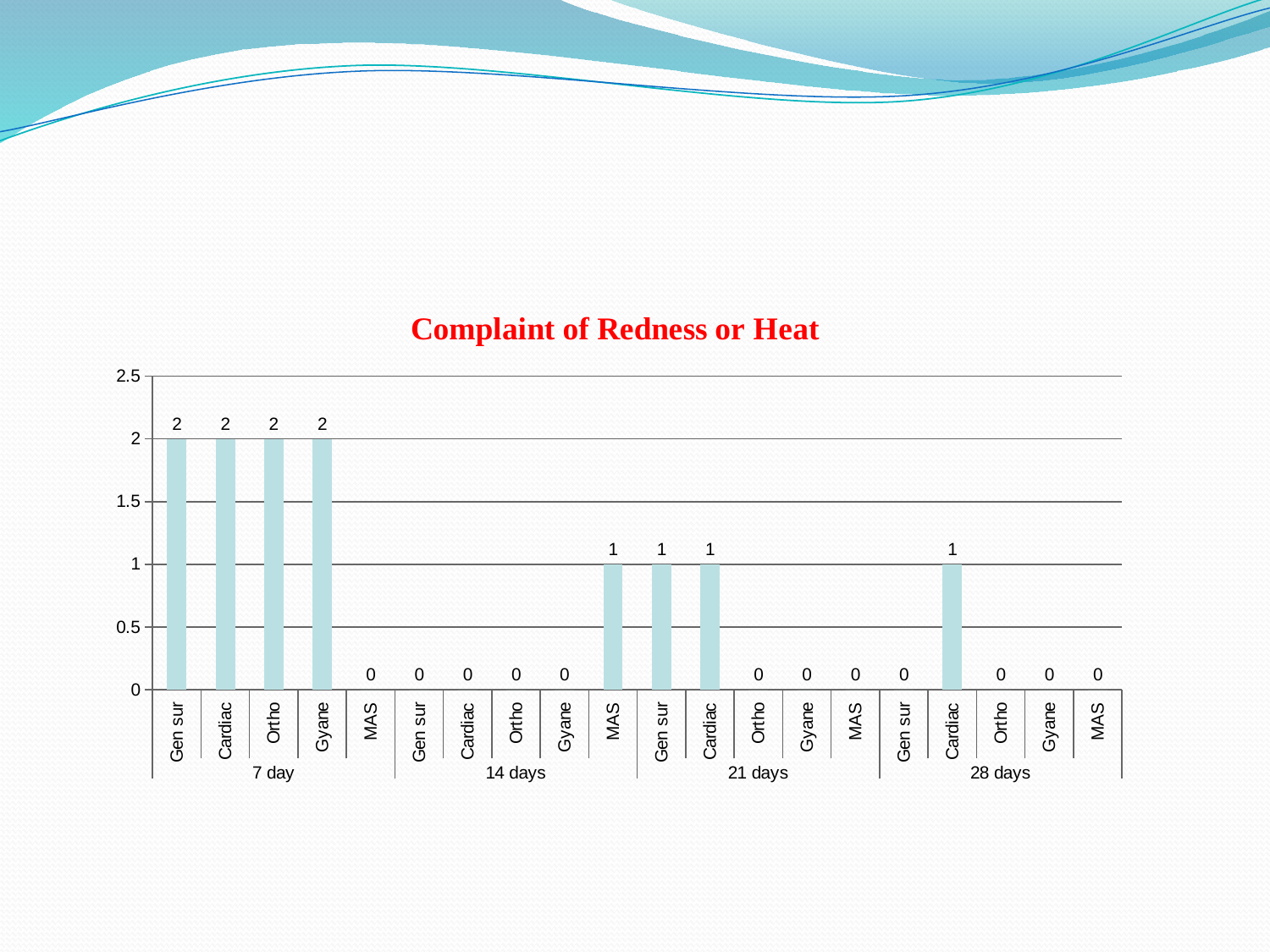
What is the difference between the value for Cardiac at 7 day and the value for Cardiac at 21 days? 1 What is the value for Ortho at 21 days? 0 How many bars (categories) are plotted on the chart in total? 20 What kind of chart is shown on the slide? Bar chart Which is larger, the value for Gen sur at 21 days or the value for Gen sur at 28 days? Gen sur at 21 days What is the value for Cardiac at 28 days? 1 What is the value for MAS at 14 days? 1 How many time-period groups are shown on the x axis? 4 What is the value for Gyane at 7 day? 2 What is the title of the chart? Complaint of Redness or Heat What is the value for Gen sur at 7 day? 2 What is the highest value shown on the y axis? 2.5